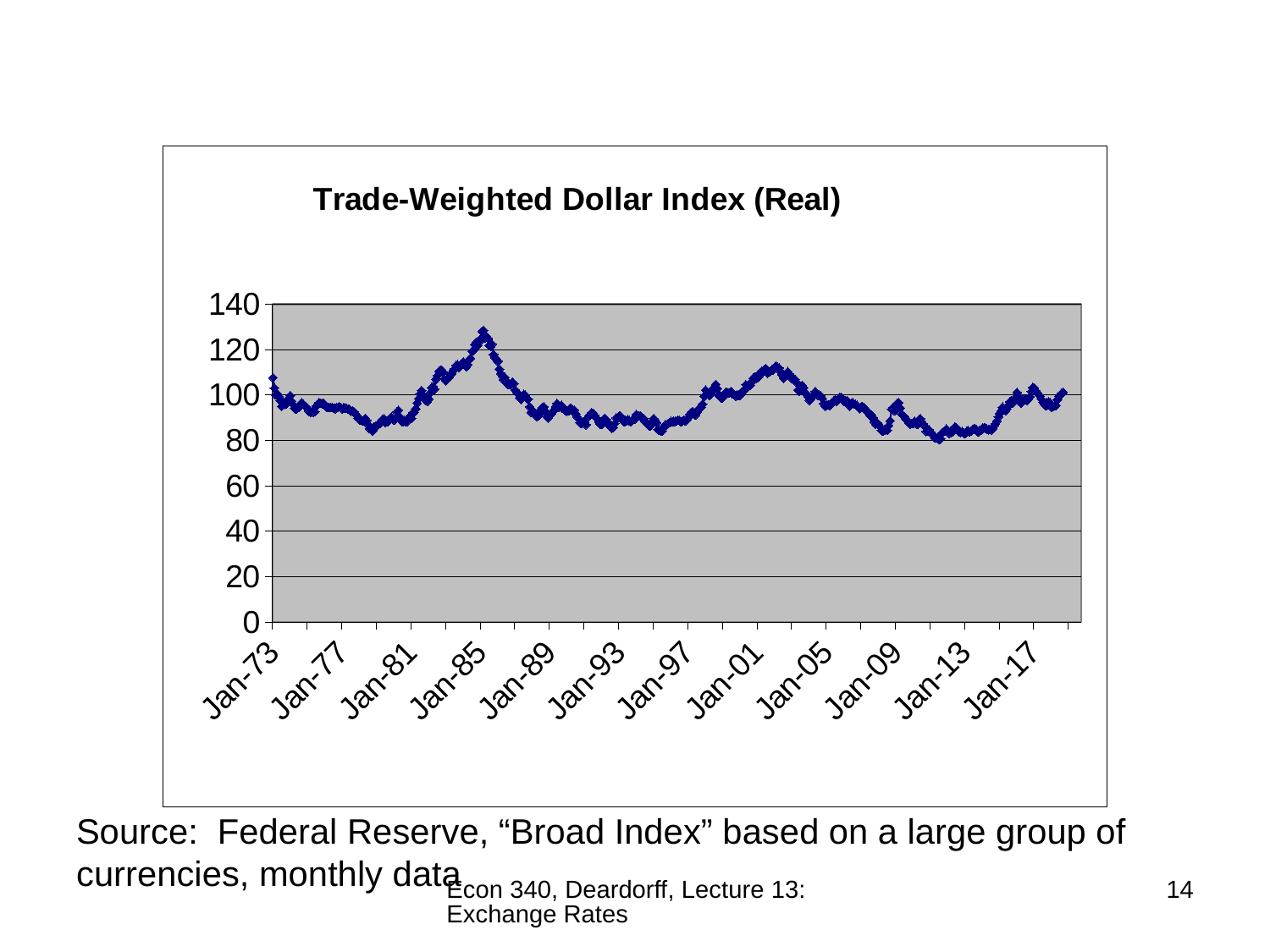
How many date labels are shown along the x axis? 12 Around which x-axis label does the index reach its highest peak? Jan-85 What kind of chart is shown on the slide? line chart Is the value of the index at Jan-09 greater or less than 100? less Which is larger, the index value at Jan-85 or at Jan-89? Jan-85 What is the highest value labelled on the vertical axis? 140 Is the peak value of the index around 1985 greater or less than 120? greater What is the title of the chart? Trade-Weighted Dollar Index (Real) Is the value of the index at Jan-73 greater or less than 100? greater Which is larger, the index value at Jan-01 or at Jan-09? Jan-01 Does the index rise or fall between Jan-85 and Jan-89? fall